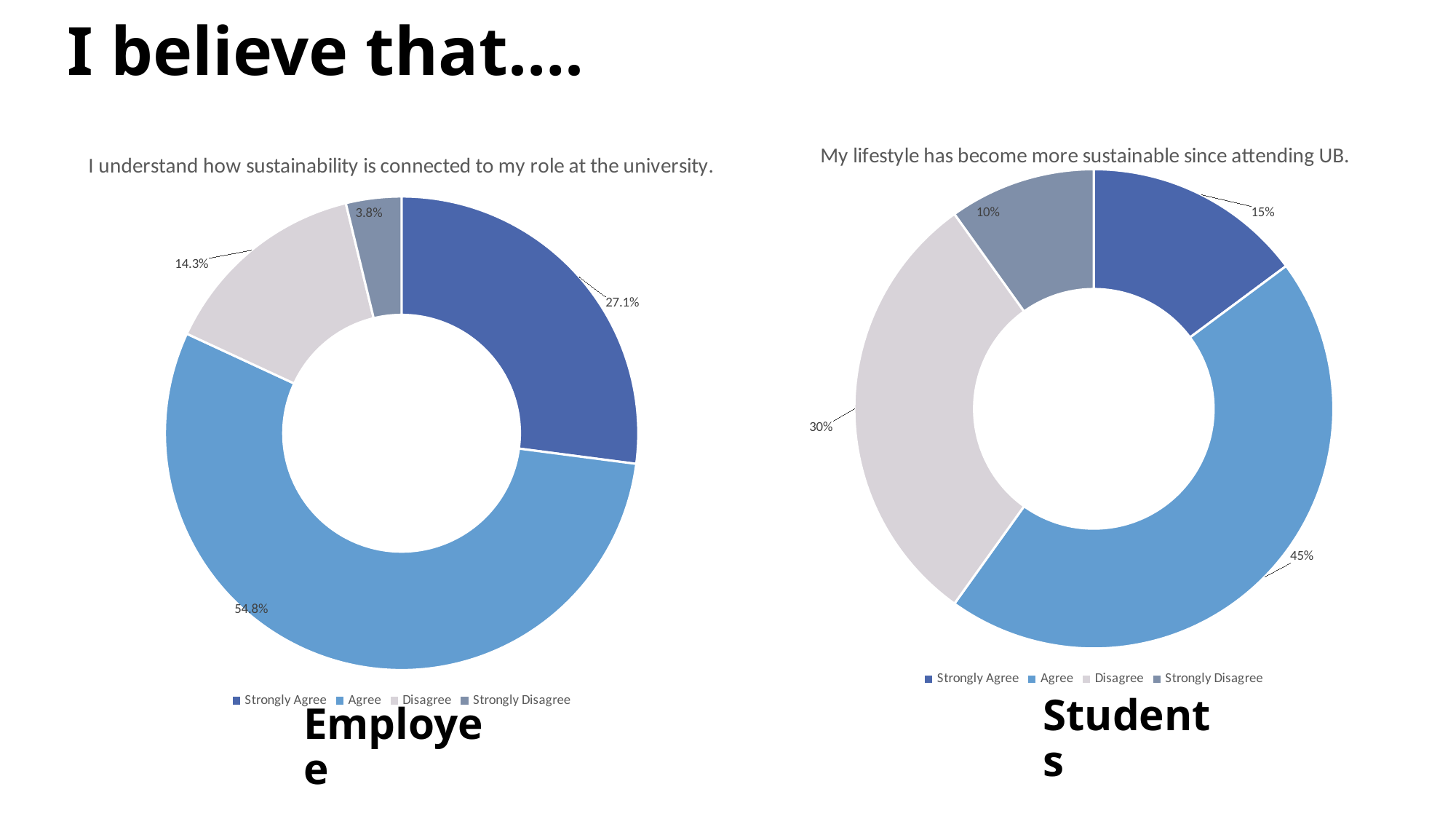
In the right chart (Students), what is the difference between the Agree and Disagree shares? 15% In the right chart (Students), what percentage of respondents chose Strongly Agree? 15% What type of chart is used on the right (Students)? Doughnut chart In the left chart (Employee), what percentage of respondents chose Agree? 54.8% How many response categories does the legend of the left chart (Employee) list? 4 In the right chart (Students), which is larger: the Strongly Agree share or the Disagree share? Disagree In the left chart (Employee), what percentage of respondents chose Strongly Disagree? 3.8% In the left chart (Employee), which response category has the largest share? Agree In the left chart (Employee), what is the difference between the Agree and Strongly Agree shares? 27.7% In the right chart (Students), which response category has the smallest share? Strongly Disagree What is the title of the right chart (Students)? My lifestyle has become more sustainable since attending UB. In the right chart (Students), what percentage of respondents chose Disagree? 30%